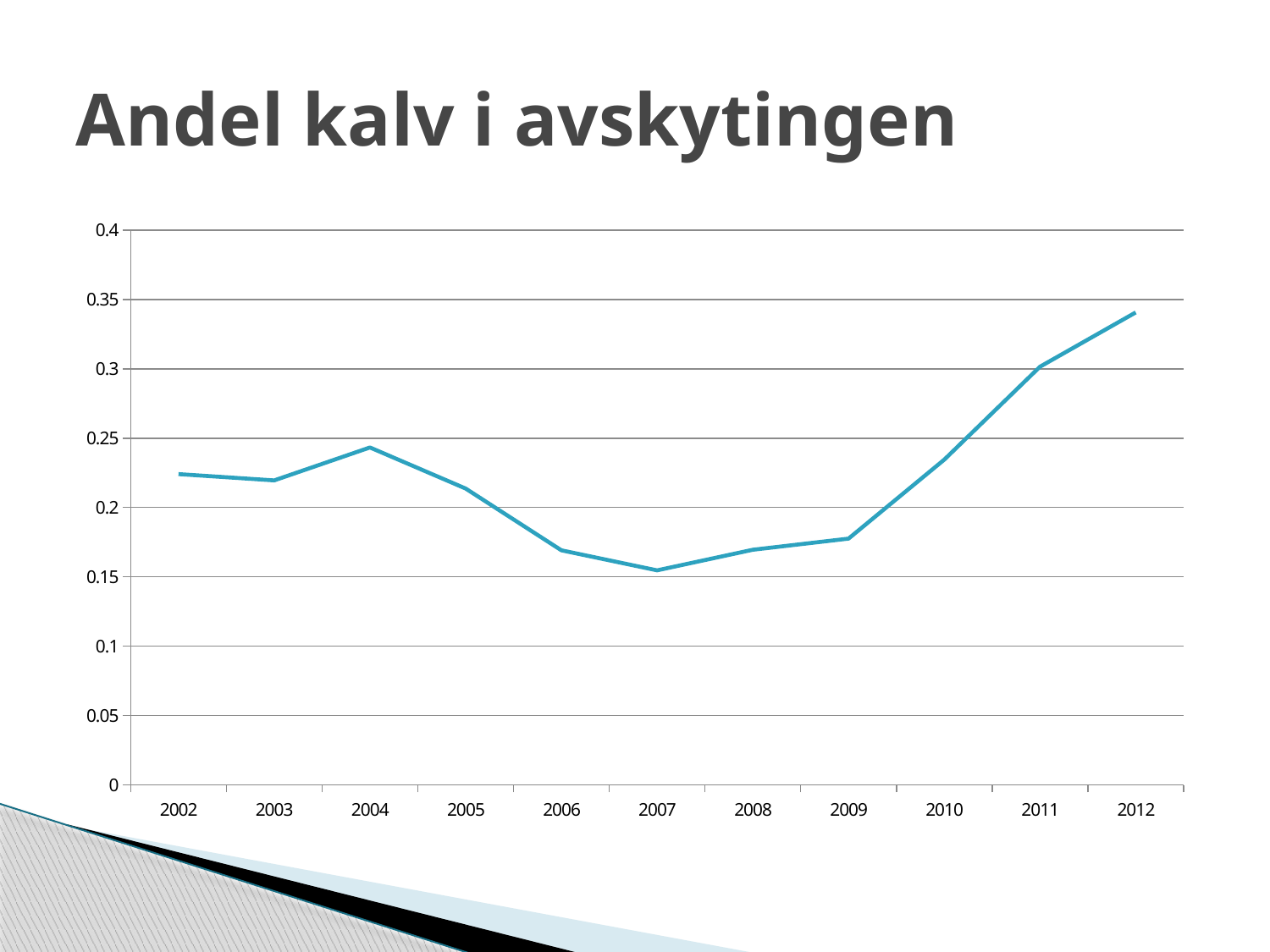
Which year has the larger value, 2009 or 2010? 2010 Is the value for 2002 greater or less than 0.2? greater What kind of chart is shown on the slide? line chart How many years are plotted along the x axis? 11 What is the title of the chart on the slide? Andel kalv i avskytingen Is the value for 2012 greater or less than 0.3? greater Is the value for 2007 greater or less than 0.2? less Which year has the highest value? 2012 Do the values rise or fall from 2009 to 2012? rise Which year has the larger value, 2004 or 2005? 2004 Which year has the lowest value? 2007